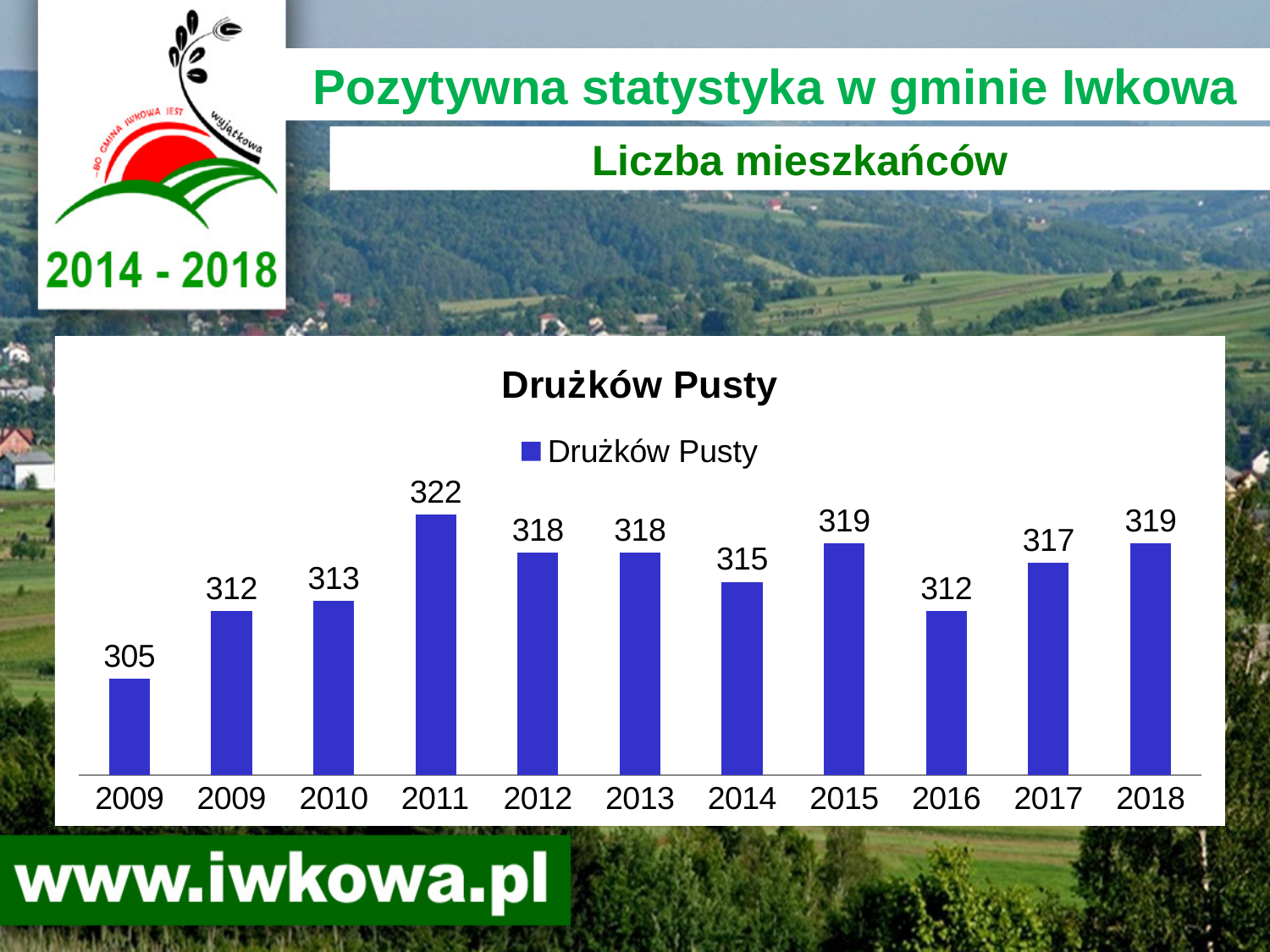
What is the value for 2011 in the Drużków Pusty chart? 322 What is the value for 2016 in the Drużków Pusty chart? 312 What is the difference between the values for 2018 and 2014 in the Drużków Pusty chart? 4 Which year has the highest value in the Drużków Pusty chart? 2011 How many series does the legend of the Drużków Pusty chart list? 1 What is the difference between the values for 2011 and 2016 in the Drużków Pusty chart? 10 What kind of chart is shown on the slide? bar chart How many bars are shown in the Drużków Pusty chart? 11 Which is larger in the Drużków Pusty chart, the value for 2015 or the value for 2017? 2015 What is the value for 2014 in the Drużków Pusty chart? 315 What is the value for 2018 in the Drużków Pusty chart? 319 Which year has the lowest value in the Drużków Pusty chart? 2009